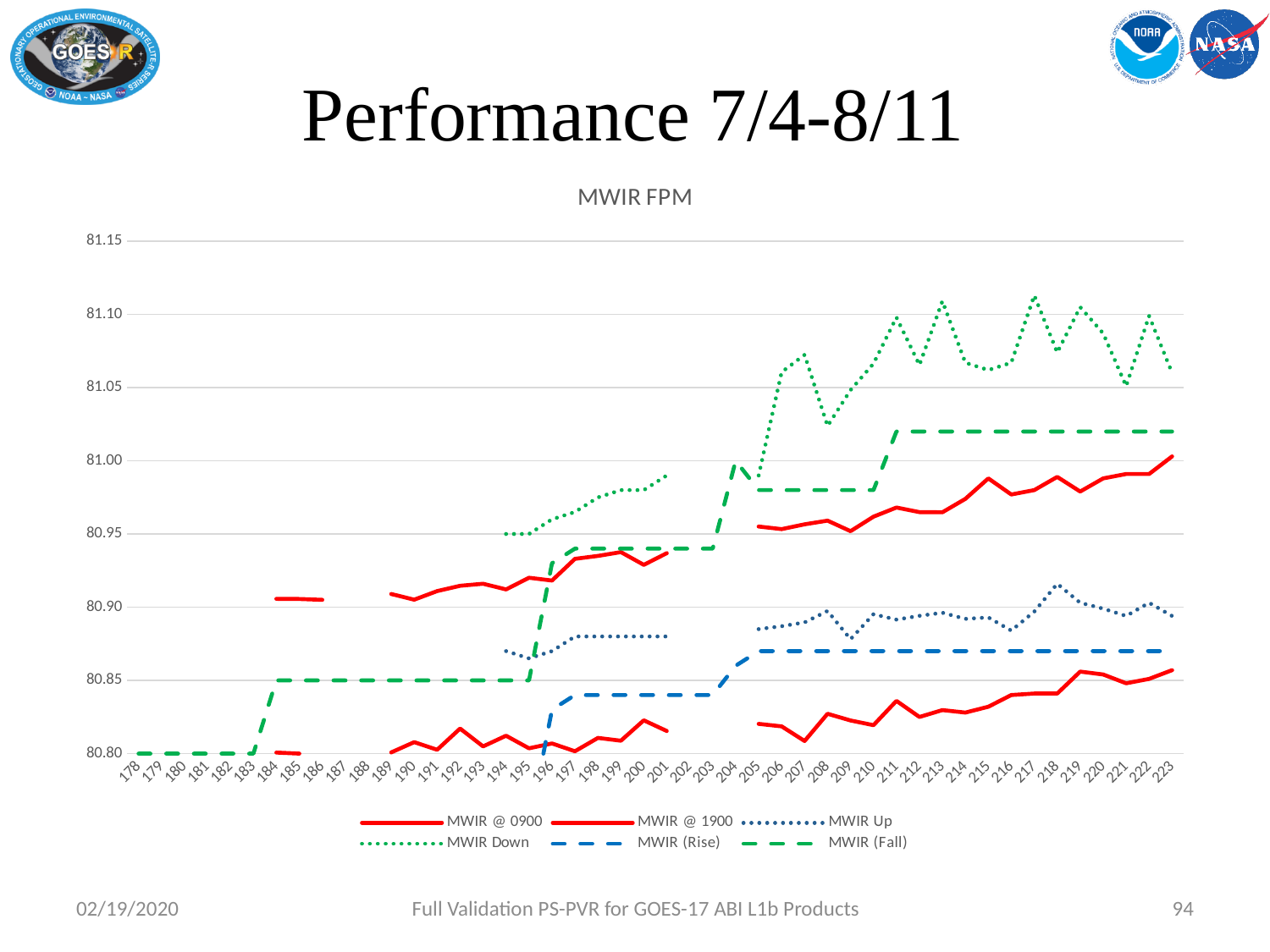
Is the value of MWIR (Rise) at 223 greater or less than 80.90? less Is the value of MWIR (Fall) at 190 greater or less than 80.90? less Is the value of MWIR (Fall) at 223 greater or less than 81.00? greater How many categories are shown on the x axis (from 178 to 223)? 46 What is the title of the chart? MWIR FPM What kind of chart is shown on the slide? line chart Does the MWIR @ 0900 series generally rise or fall from 189 to 223? rise Which series is drawn as a green dotted line? MWIR Down How many series does the legend list? 6